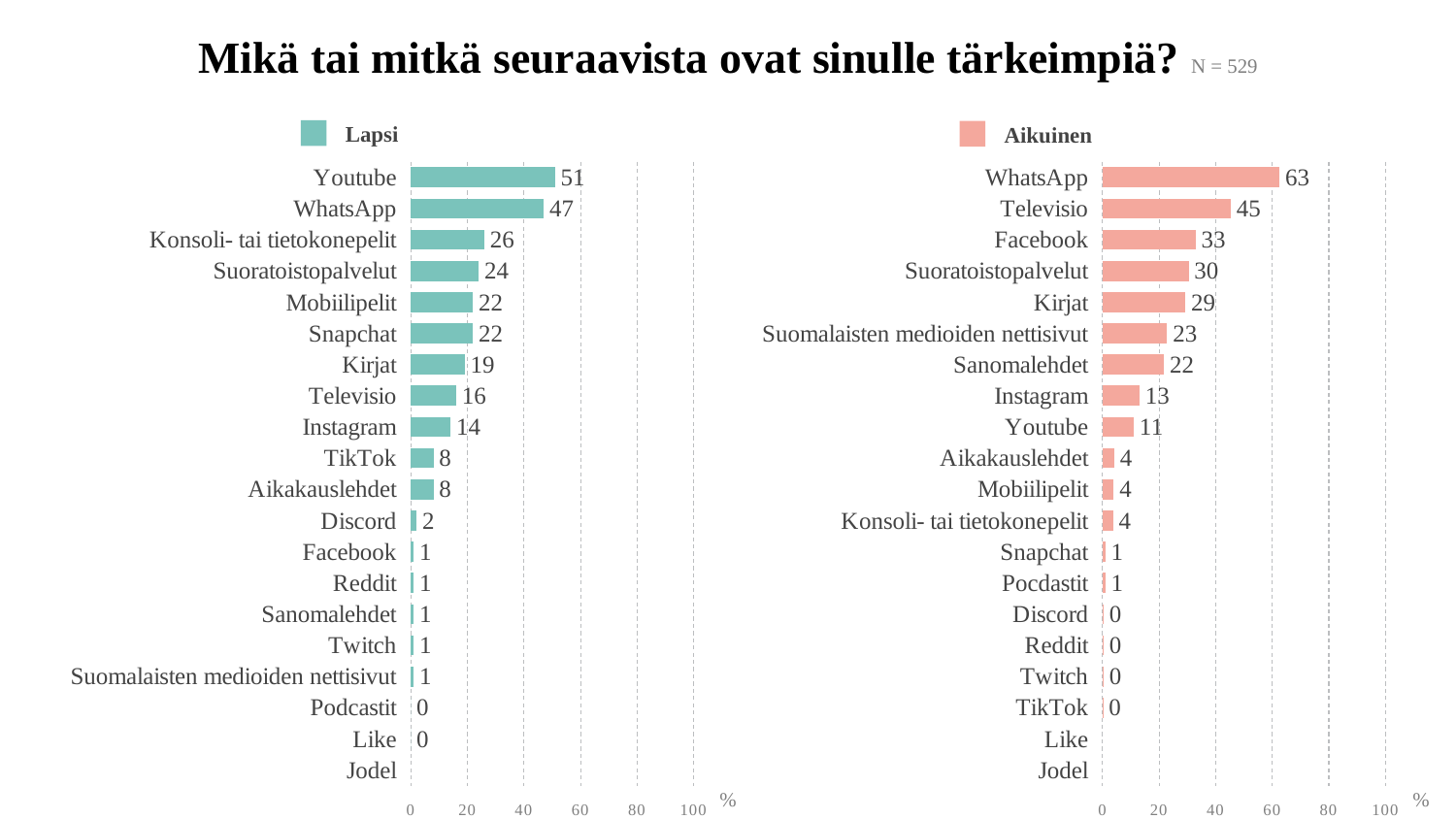
In the Lapsi chart, which category has the highest value? Youtube In the Lapsi chart, what is the value for Youtube? 51 Which is larger: the value for Televisio in the Lapsi chart or the value for Televisio in the Aikuinen chart? Aikuinen What kind of chart is the Aikuinen chart? bar chart In the Lapsi chart, what is the difference between the values for Youtube and WhatsApp? 4 In the Aikuinen chart, what is the difference between the values for WhatsApp and Facebook? 30 In the Aikuinen chart, what is the value for Televisio? 45 What is the N value shown next to the slide title? N = 529 In the Aikuinen chart, which category has the highest value? WhatsApp In the Lapsi chart, is the value for Konsoli- tai tietokonepelit greater or less than 20? greater In the Aikuinen chart, what is the value for Kirjat? 29 How many categories are listed in the Lapsi chart? 20